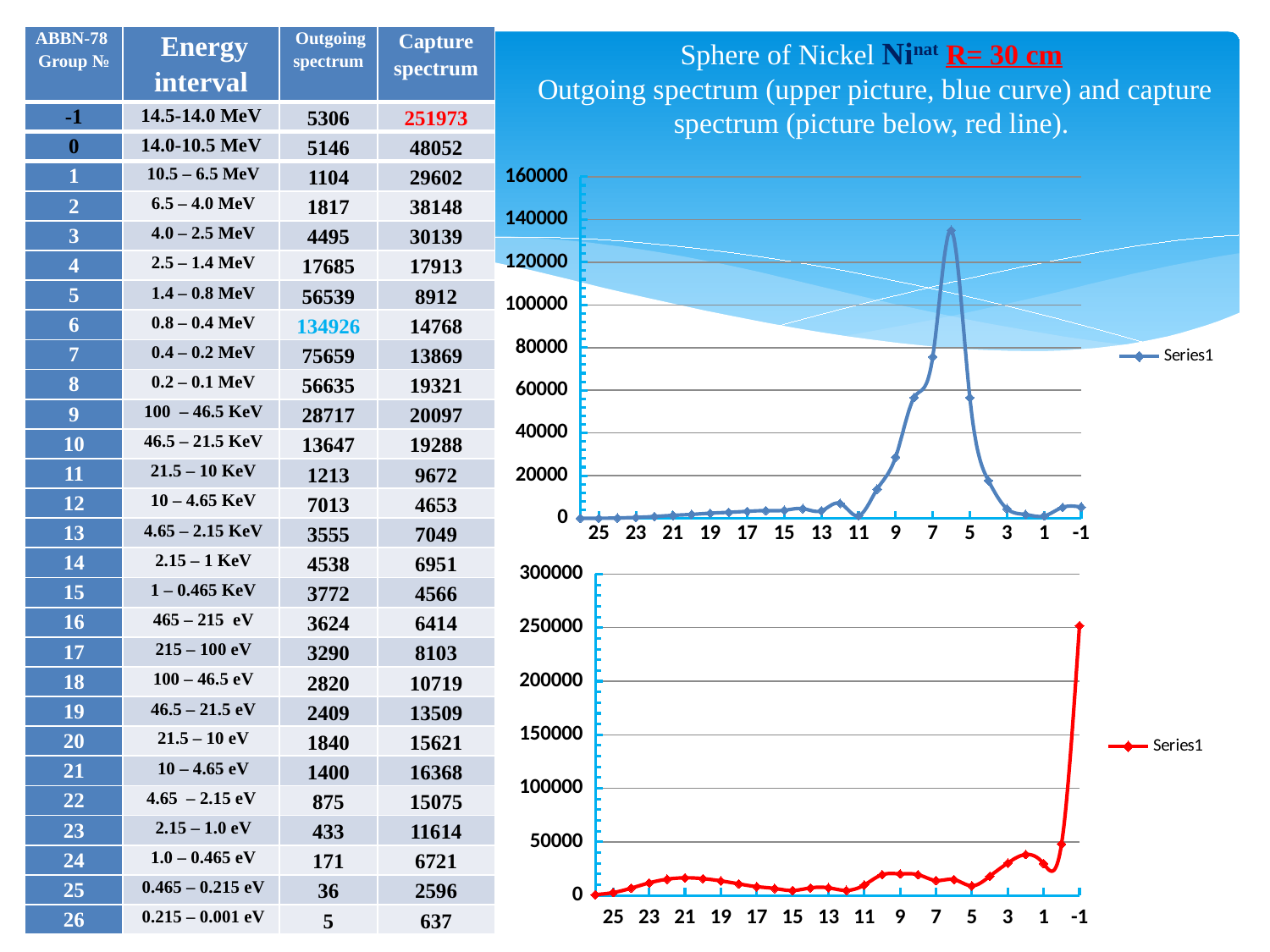
What kind of chart is the upper chart on the slide? line chart How many series does the legend of the lower chart list? 1 What is the legend entry shown next to the upper chart? Series1 In the upper chart, is the peak value at group 6 greater or less than 120000? greater In the lower chart, is the value at group -1 greater or less than 200000? greater What colour is the line in the lower chart? red In the lower chart, does the red curve rise or fall between group 3 and group -1? rise In the lower chart, at which x-axis group does the red curve reach its highest value? -1 In the upper chart, which is larger, the value at group 6 or the value at group 7? group 6 In the upper chart, at which x-axis group does the blue curve reach its highest value? 6 In the lower chart, is the value at group 3 greater or less than 50000? less